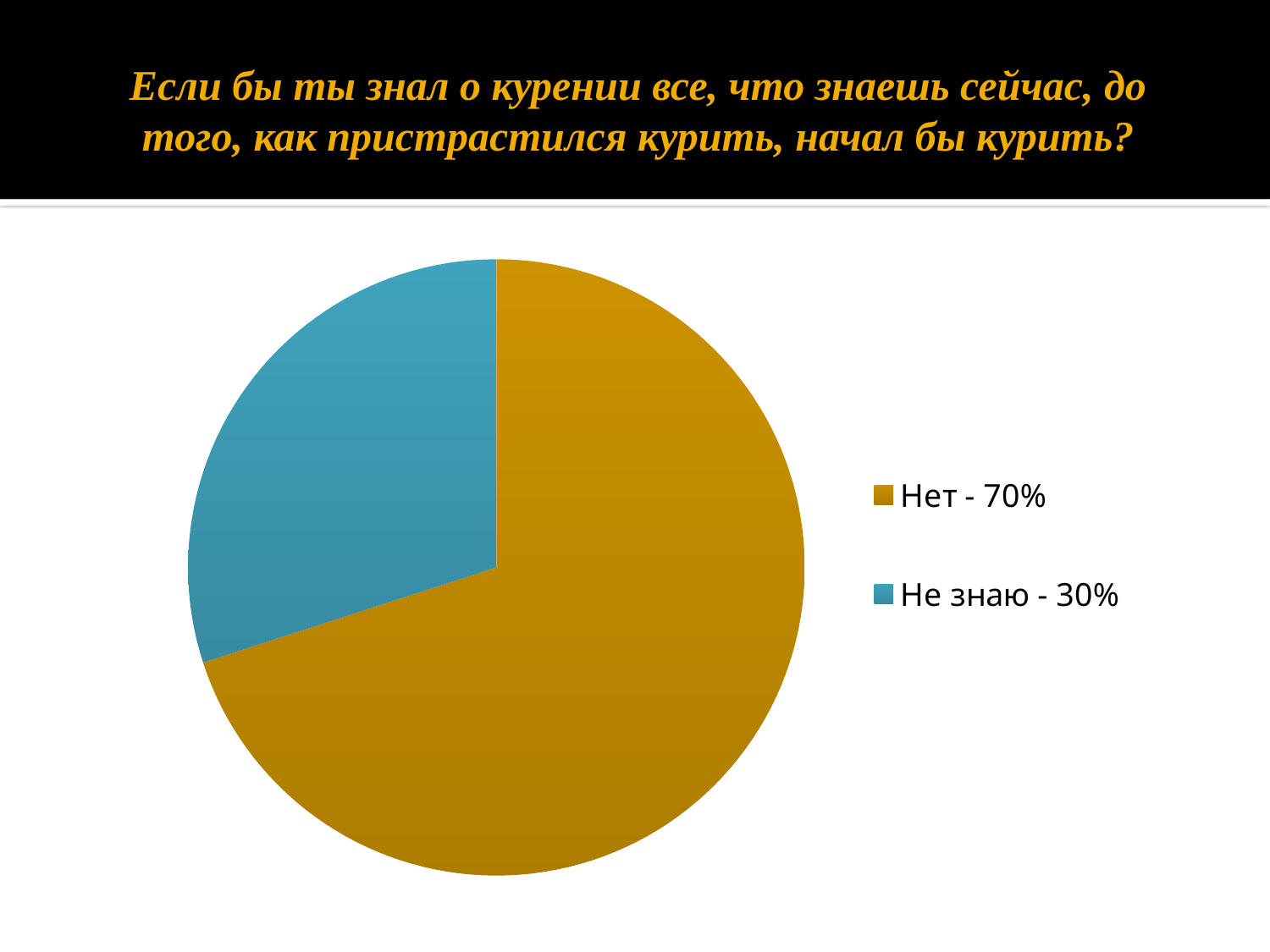
What share of the pie does the "Нет" slice represent? 70% Which category has the largest slice of the pie? Нет What kind of chart is shown on the slide? pie chart What share of the pie does the "Не знаю" slice represent? 30% How many slices does the pie chart have? 2 How many entries does the legend list? 2 What colour is the "Нет" slice? gold What colour is the "Не знаю" slice? blue Which is larger, the "Нет" slice or the "Не знаю" slice? Нет Which category has the smallest slice of the pie? Не знаю What is the difference in percentage points between the "Нет" and "Не знаю" slices? 40%